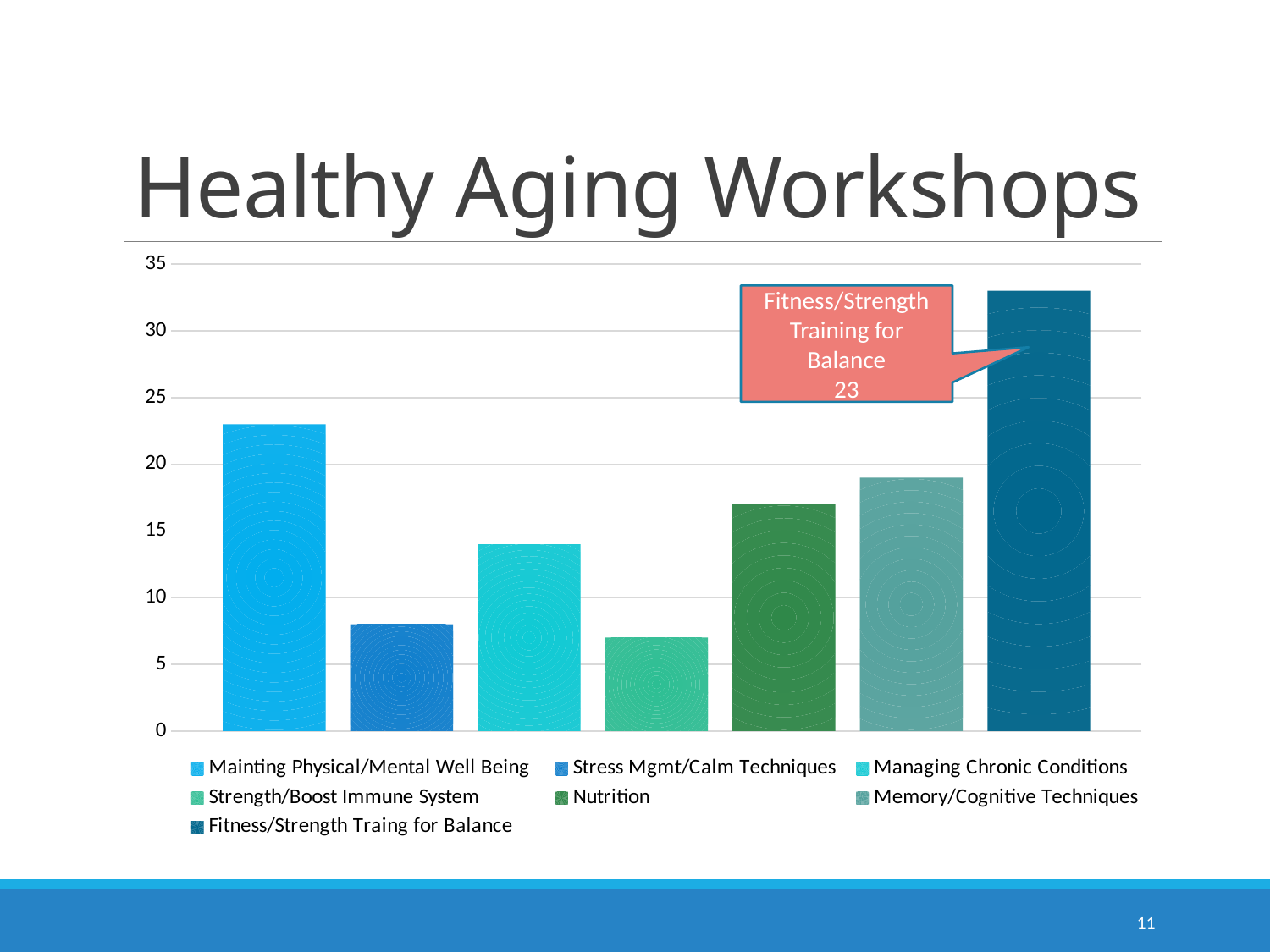
Is the value for Managing Chronic Conditions greater or less than 10? greater Is the value for Nutrition greater or less than 15? greater What kind of chart is shown on the slide? bar chart What is the title of the slide containing the chart? Healthy Aging Workshops Which is larger, the value for Mainting Physical/Mental Well Being or the value for Nutrition? Mainting Physical/Mental Well Being Which is larger, the value for Memory/Cognitive Techniques or the value for Managing Chronic Conditions? Memory/Cognitive Techniques How many bars are plotted in the chart? 7 Is the value for Fitness/Strength Traing for Balance greater or less than 30? greater How many entries does the chart legend list? 7 Which workshop category has the highest bar? Fitness/Strength Traing for Balance